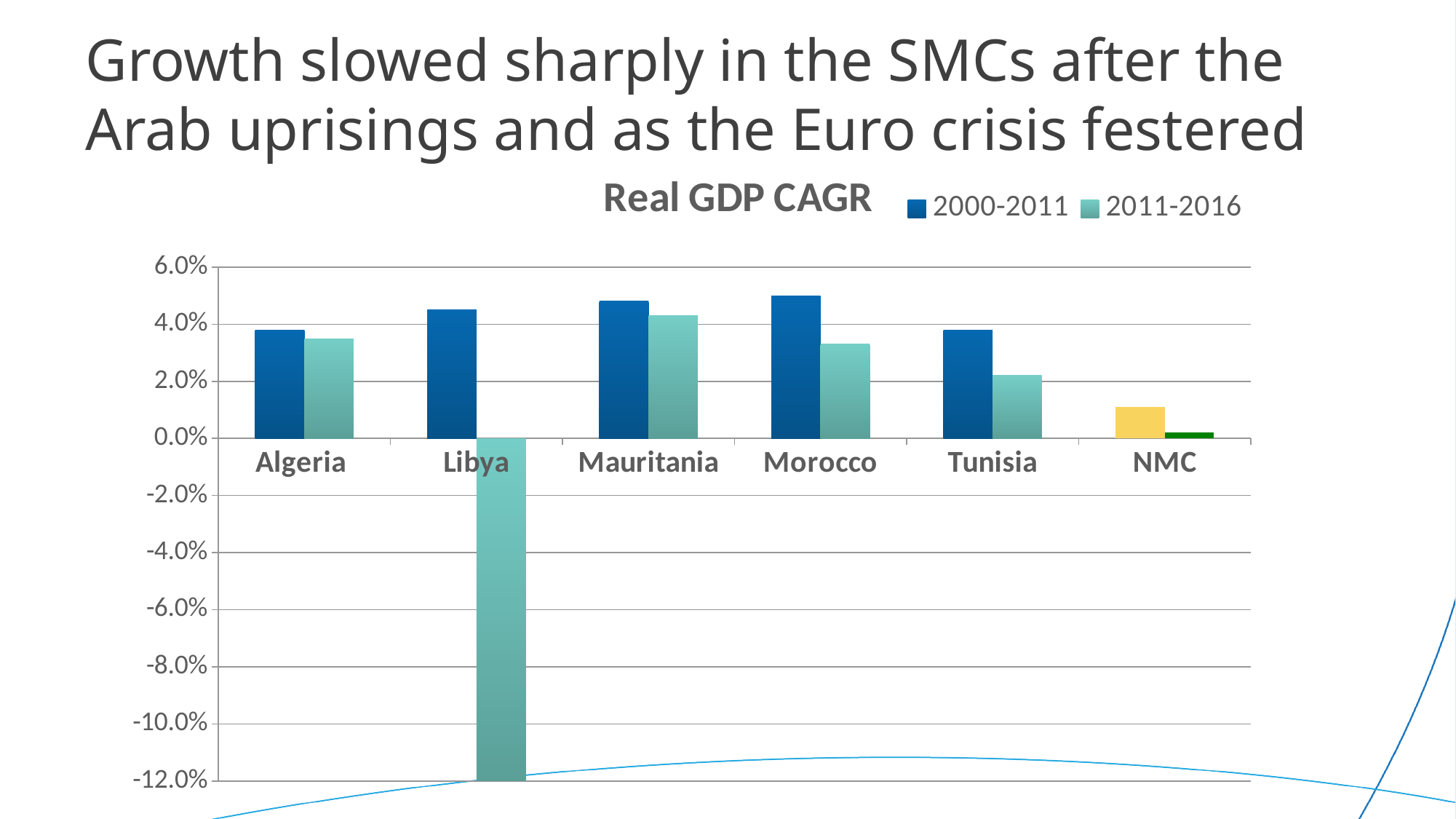
Which category has the lowest value for the 2011-2016 series? Libya Is the 2000-2011 value for NMC greater or less than 2.0%? less Is the 2011-2016 value for Tunisia greater or less than 4.0%? less Which is larger, the 2011-2016 value for Morocco or the 2011-2016 value for Tunisia? Morocco What kind of chart is shown on the slide? bar chart How many series does the legend list? 2 Which is larger, the 2000-2011 value for Libya or the 2000-2011 value for Algeria? Libya How many categories are shown on the x axis? 6 Is the 2011-2016 value for Libya greater or less than -10.0%? less What is the title of the chart? Real GDP CAGR Which category has the highest value for the 2011-2016 series? Mauritania